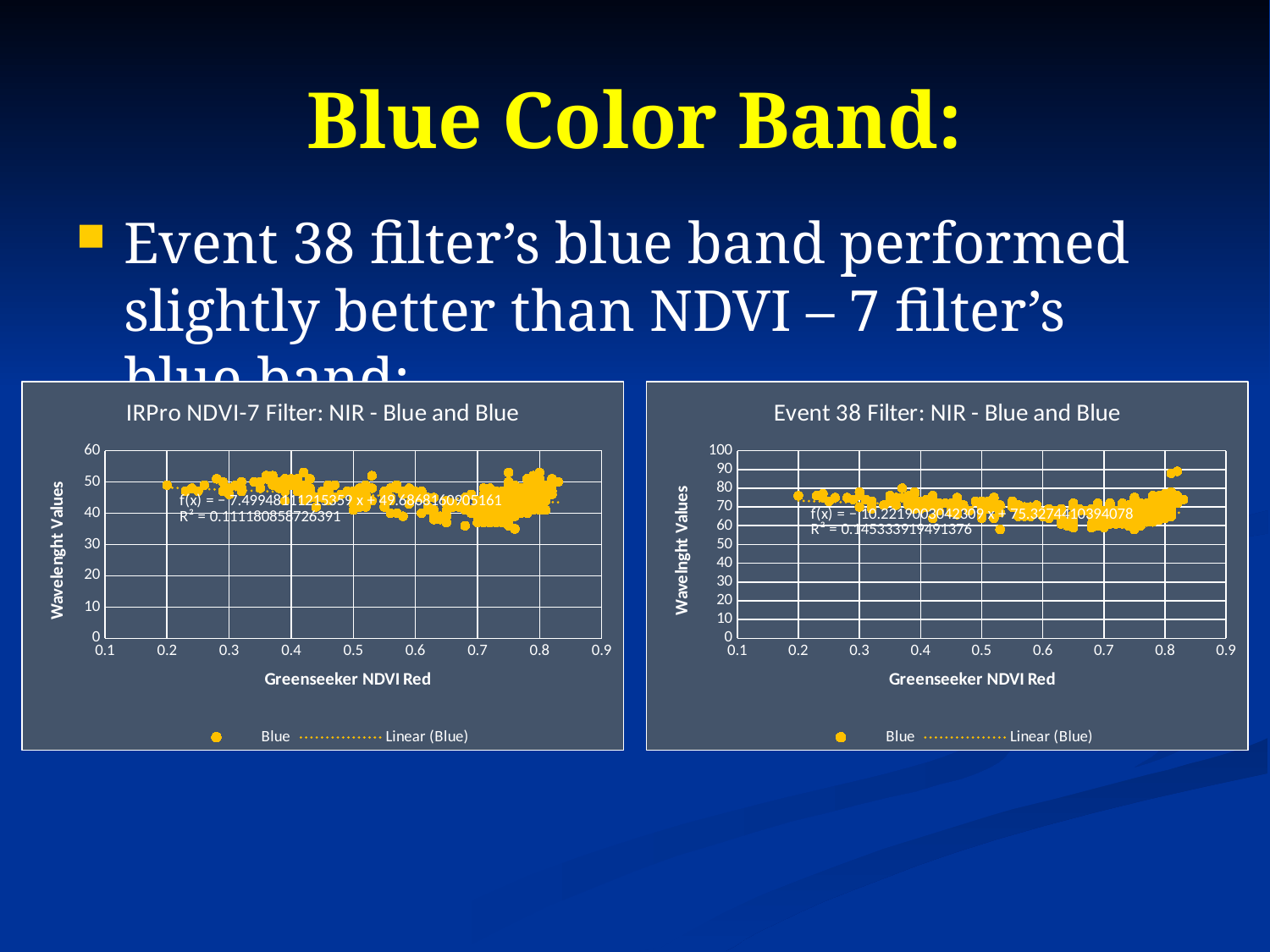
In the right chart (Event 38 Filter), are the plotted wavelength values near x = 0.5 greater or less than 50? greater In the left chart (IRPro NDVI-7 Filter), are the plotted wavelength values near x = 0.7 greater or less than 60? less In the left chart (IRPro NDVI-7 Filter), do the plotted wavelength values generally rise or fall as Greenseeker NDVI Red increases from 0.2 to 0.7? fall In the left chart (IRPro NDVI-7 Filter), are the plotted wavelength values near x = 0.2 greater or less than 30? greater What is the x-axis title of the left chart (IRPro NDVI-7 Filter)? Greenseeker NDVI Red What kind of chart is the right chart titled 'Event 38 Filter: NIR - Blue and Blue'? scatter chart What is the highest tick value on the y-axis of the right chart (Event 38 Filter)? 100 What kind of chart is the left chart titled 'IRPro NDVI-7 Filter: NIR - Blue and Blue'? scatter chart How many entries does the legend of the left chart (IRPro NDVI-7 Filter) list? 2 How many entries does the legend of the right chart (Event 38 Filter) list? 2